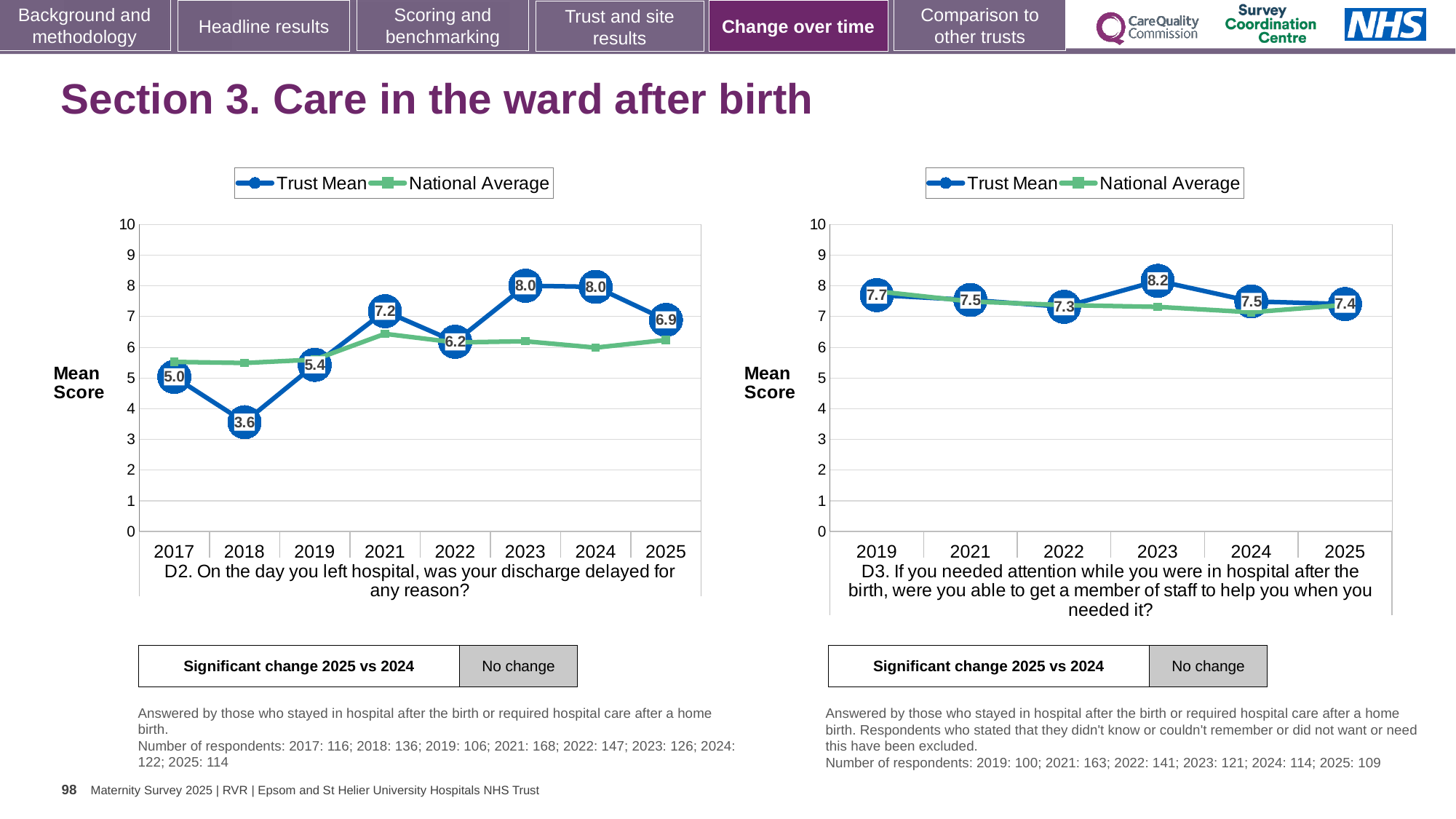
In the D3 chart (right), what is the Trust Mean score for 2023? 8.2 How many series does the legend of the D3 chart (right) list? 2 In the D2 chart (left), which year has the lowest Trust Mean score? 2018 What type of chart is the D2 chart (left)? Line chart In the D2 chart (left), what is the Trust Mean score for 2018? 3.6 In the D2 chart (left), what is the difference between the Trust Mean scores for 2021 and 2022? 1.0 In the D3 chart (right), what is the difference between the Trust Mean scores for 2023 and 2025? 0.8 In the D3 chart (right), is the Trust Mean score for 2019 larger or smaller than the score for 2022? larger In the D3 chart (right), which year has the highest Trust Mean score? 2023 In the D2 chart (left), what is the Trust Mean score for 2025? 6.9 In the D2 chart (left), how many years are shown on the x axis? 8 In the D2 chart (left), is the National Average for 2017 greater or less than 5? greater